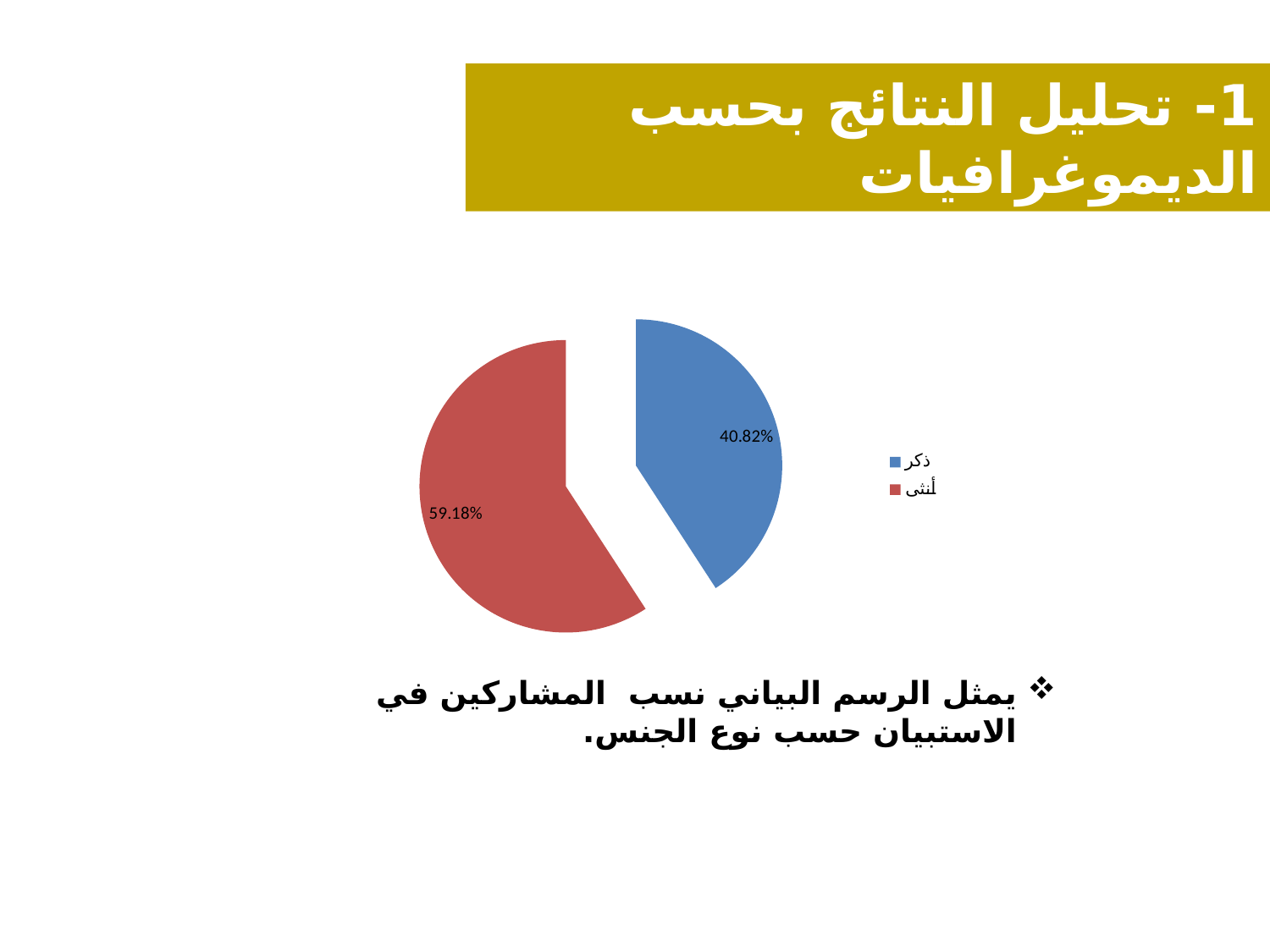
What is the value shown for أنثى (female) in the pie chart? 59.18% What kind of chart is shown on the slide? pie chart What colour is the slice for ذكر in the pie chart? blue Which is larger in the pie chart, the share for ذكر or the share for أنثى? أنثى How many slices does the pie chart have? 2 What is the value shown for ذكر (male) in the pie chart? 40.82% How many entries does the legend of the pie chart list? 2 What colour is the slice for أنثى in the pie chart? red What share of the pie does the blue slice represent? 40.82% Which category has the largest slice of the pie chart? أنثى Which category has the smallest slice of the pie chart? ذكر What is the difference between the أنثى and ذكر percentages in the pie chart? 18.36%